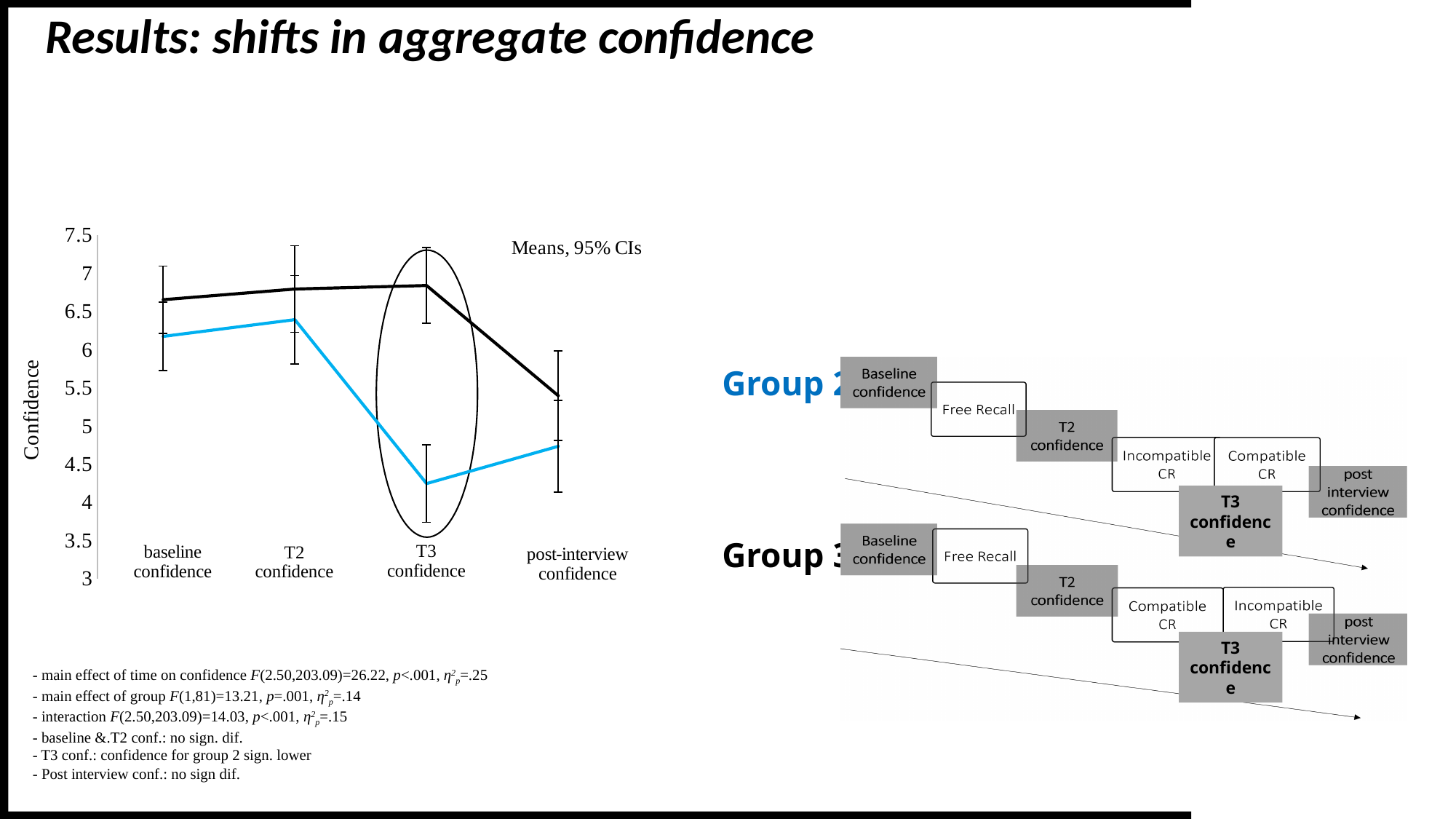
What is the title of the y axis of the chart? Confidence At post-interview confidence, which line has the higher value, the black line or the blue line? black line Does the blue line rise or fall from T2 confidence to T3 confidence? fall At which category does the black line reach its lowest value? post-interview confidence How many categories are shown along the x axis of the chart? 4 Is the value of the blue line at T3 confidence greater or less than 5? less What type of chart is shown on the slide? line chart Is the value of the black line at post-interview confidence greater or less than 6? less Is the value of the black line at T3 confidence greater or less than 6.5? greater At which category does the blue line reach its lowest value? T3 confidence At T3 confidence, which line has the higher value, the black line or the blue line? black line What annotation text appears in the upper right of the chart's plot area? Means, 95% CIs